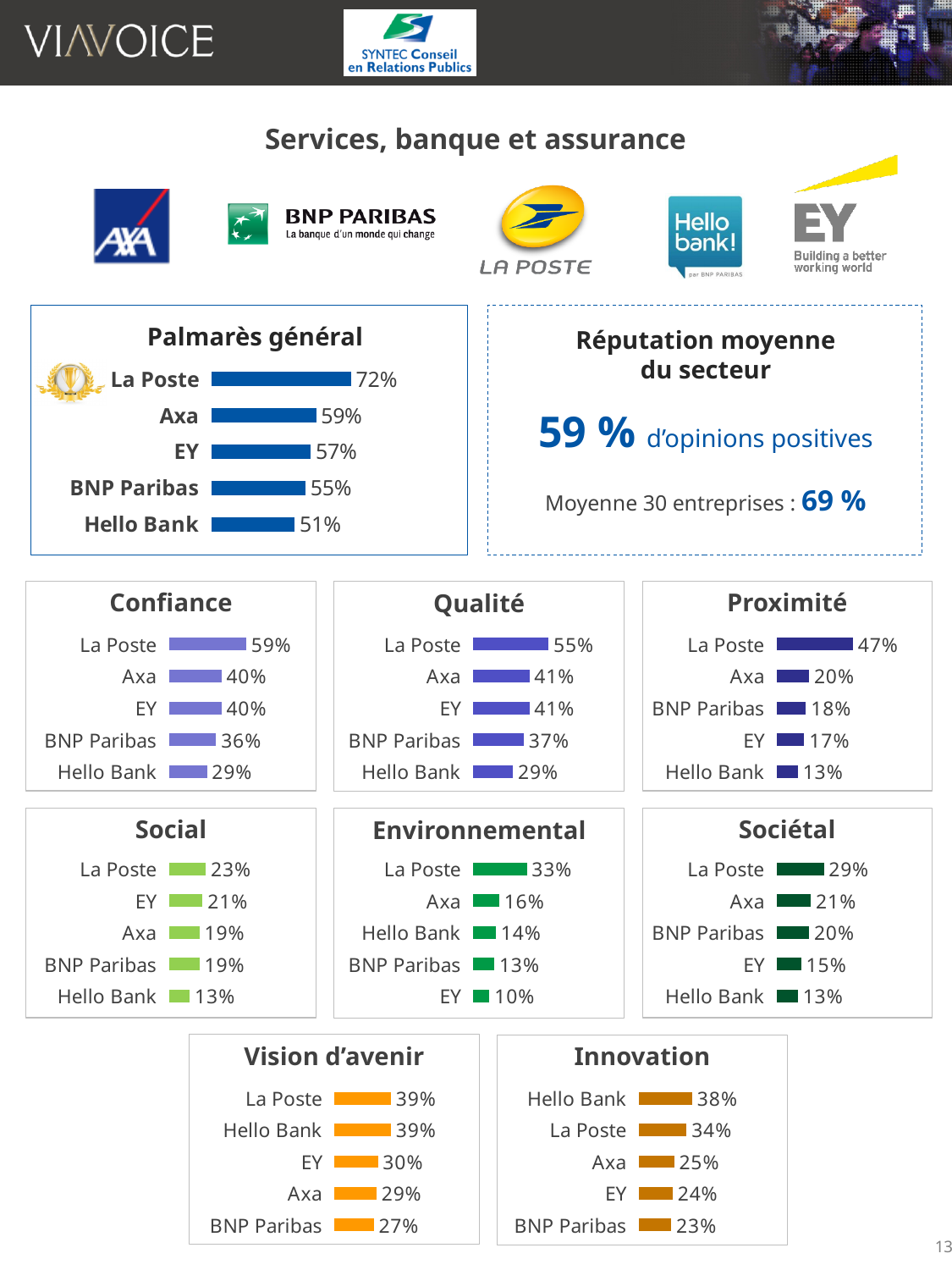
In the 'Palmarès général' chart, what is the value for La Poste? 72% In the 'Qualité' chart, which company has the highest value? La Poste In the 'Confiance' chart, what is the value for BNP Paribas? 36% In the 'Innovation' chart, which company has the highest value? Hello Bank What type of chart is the 'Palmarès général' chart? Bar chart In the 'Social' chart, which is larger, the value for EY or the value for Hello Bank? EY In the 'Sociétal' chart, what is the difference between La Poste and Axa? 8 percentage points In the 'Palmarès général' chart, which company has the lowest value? Hello Bank How many companies are shown in the 'Vision d'avenir' chart? 5 In the 'Palmarès général' chart, what is the difference between La Poste and Hello Bank? 21 percentage points In the 'Environnemental' chart, what is the value for EY? 10% In the 'Proximité' chart, what is the value for Hello Bank? 13%